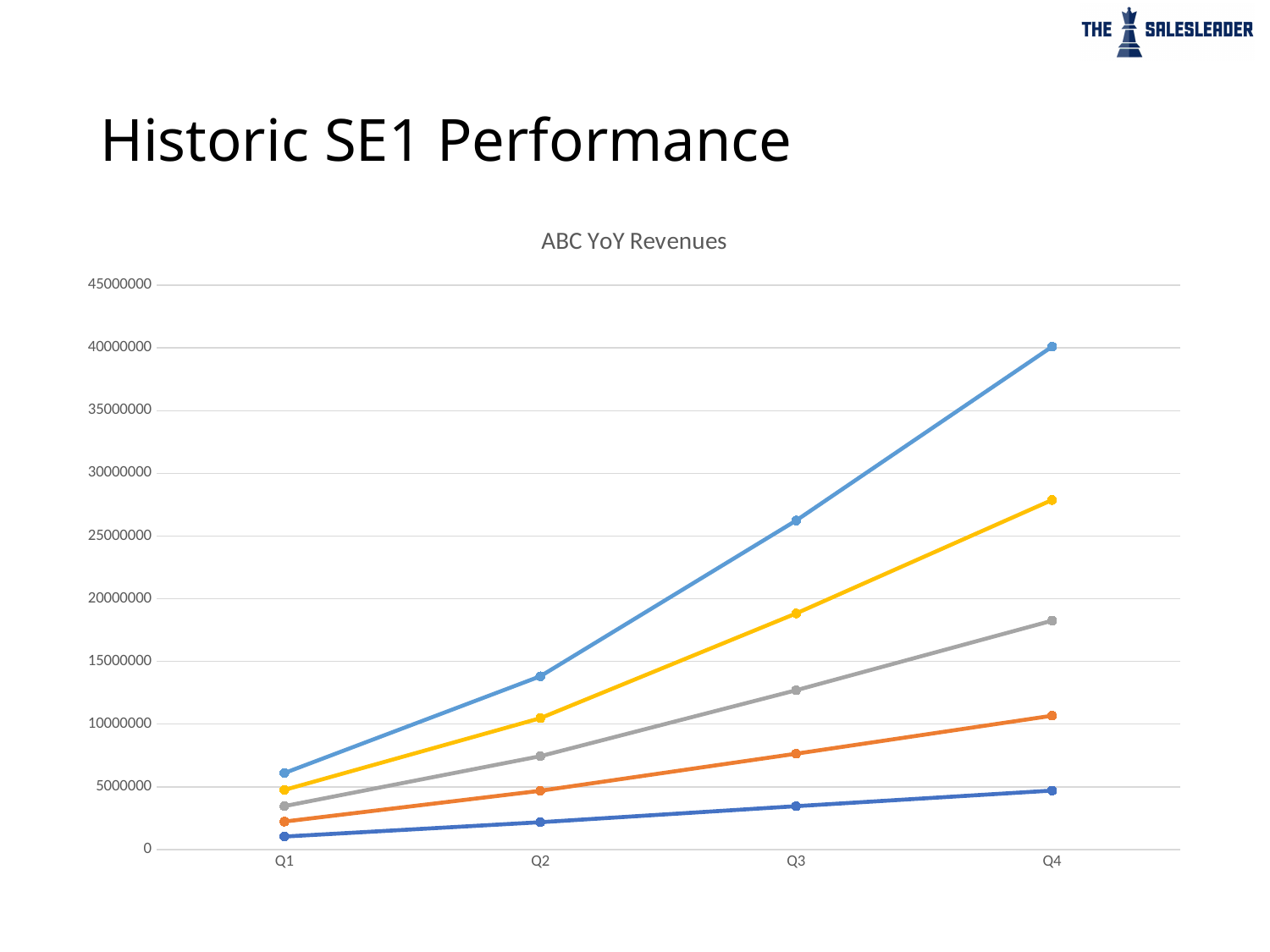
Which line has the highest value at Q4? the light blue line At Q3, which is larger: the value of the yellow line or the value of the gray line? the yellow line What kind of chart is shown on the slide? line chart How many lines are plotted on the chart? 5 Is the value of the gray line at Q4 greater or less than 20000000? less Do the values of the light blue line rise or fall from Q1 to Q4? rise How many quarters are shown on the x axis of the chart? 4 Which line has the lowest value at Q4? the dark blue line Is the value of the light blue line at Q2 greater or less than 15000000? less Is the value of the light blue line at Q4 greater or less than 35000000? greater What is the title of the chart? ABC YoY Revenues